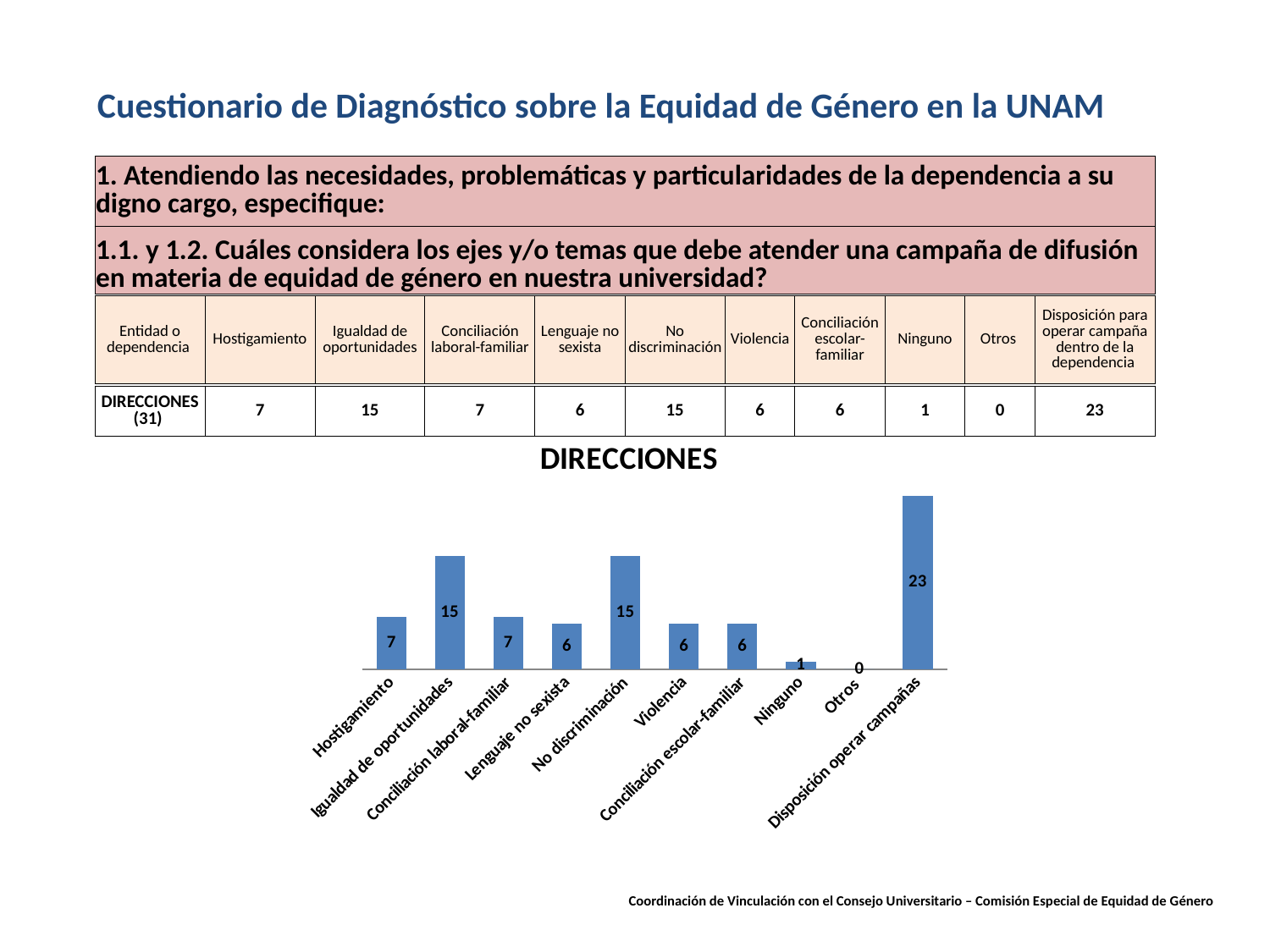
Which is larger in the DIRECCIONES chart, the value for No discriminación or the value for Violencia? No discriminación What is the value for Disposición operar campañas in the DIRECCIONES chart? 23 What is the value for Hostigamiento in the DIRECCIONES chart? 7 What is the difference between the values for Hostigamiento and Lenguaje no sexista in the DIRECCIONES chart? 1 How many categories are shown in the DIRECCIONES chart? 10 What kind of chart is the DIRECCIONES chart? Bar chart Which category has the lowest value in the DIRECCIONES chart? Otros What is the title of the chart on the slide? DIRECCIONES What is the difference between the values for Disposición operar campañas and Igualdad de oportunidades in the DIRECCIONES chart? 8 What is the value for Conciliación escolar-familiar in the DIRECCIONES chart? 6 Which category has the highest value in the DIRECCIONES chart? Disposición operar campañas What is the value for Ninguno in the DIRECCIONES chart? 1